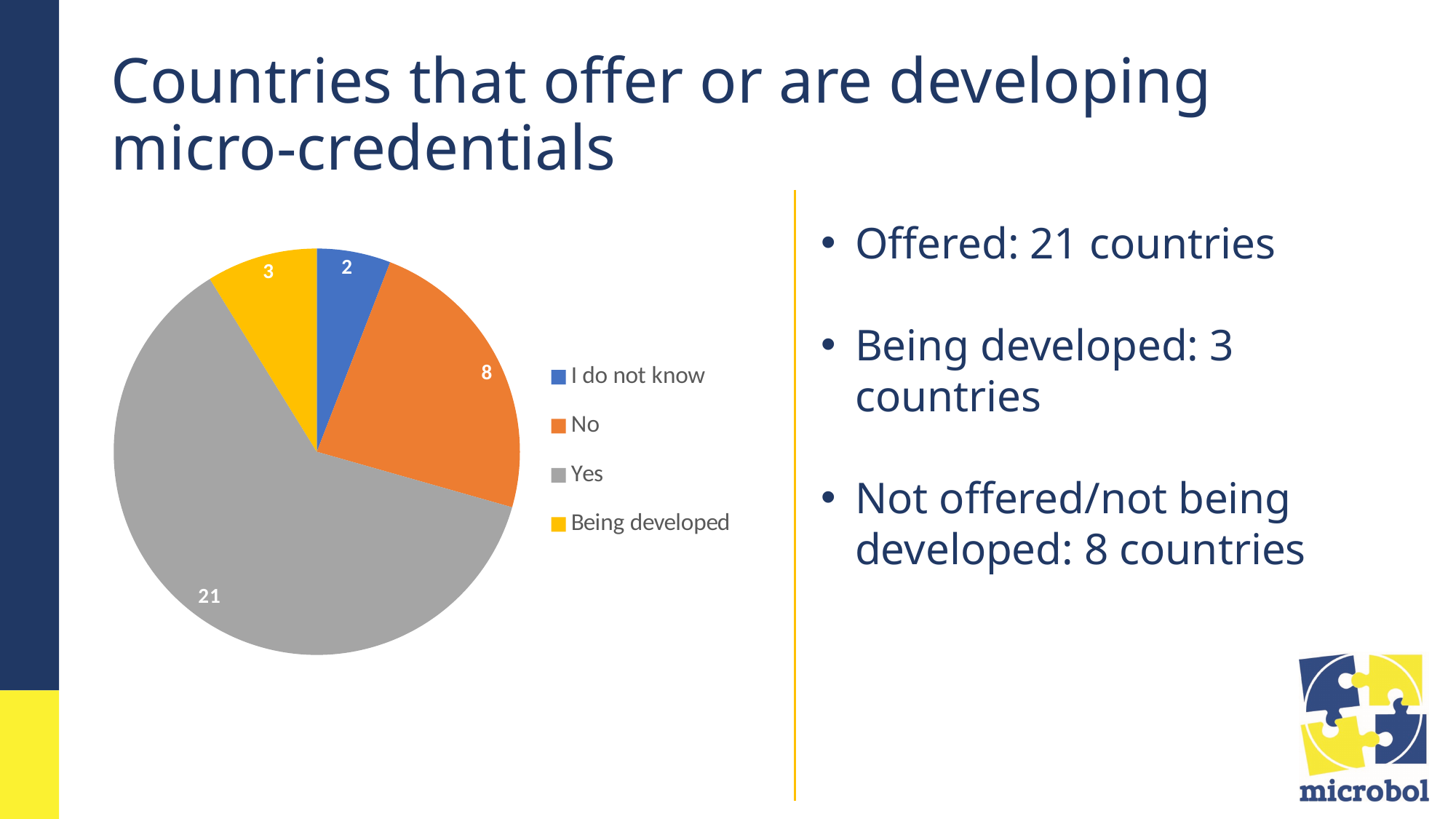
Which category has the largest slice in the pie chart? Yes What is the total of all slices in the pie chart? 34 Which colour represents "Being developed" in the pie chart? yellow How many categories does the pie chart have? 4 How many countries answered "Yes" in the pie chart? 21 What is the difference between the "Yes" and "No" values in the pie chart? 13 What is the value for "I do not know" in the pie chart? 2 What type of chart is shown on the slide? pie chart What is the value for "Being developed" in the pie chart? 3 What is the value for "No" in the pie chart? 8 Which category has the smallest slice in the pie chart? I do not know Which is larger in the pie chart, "No" or "Being developed"? No